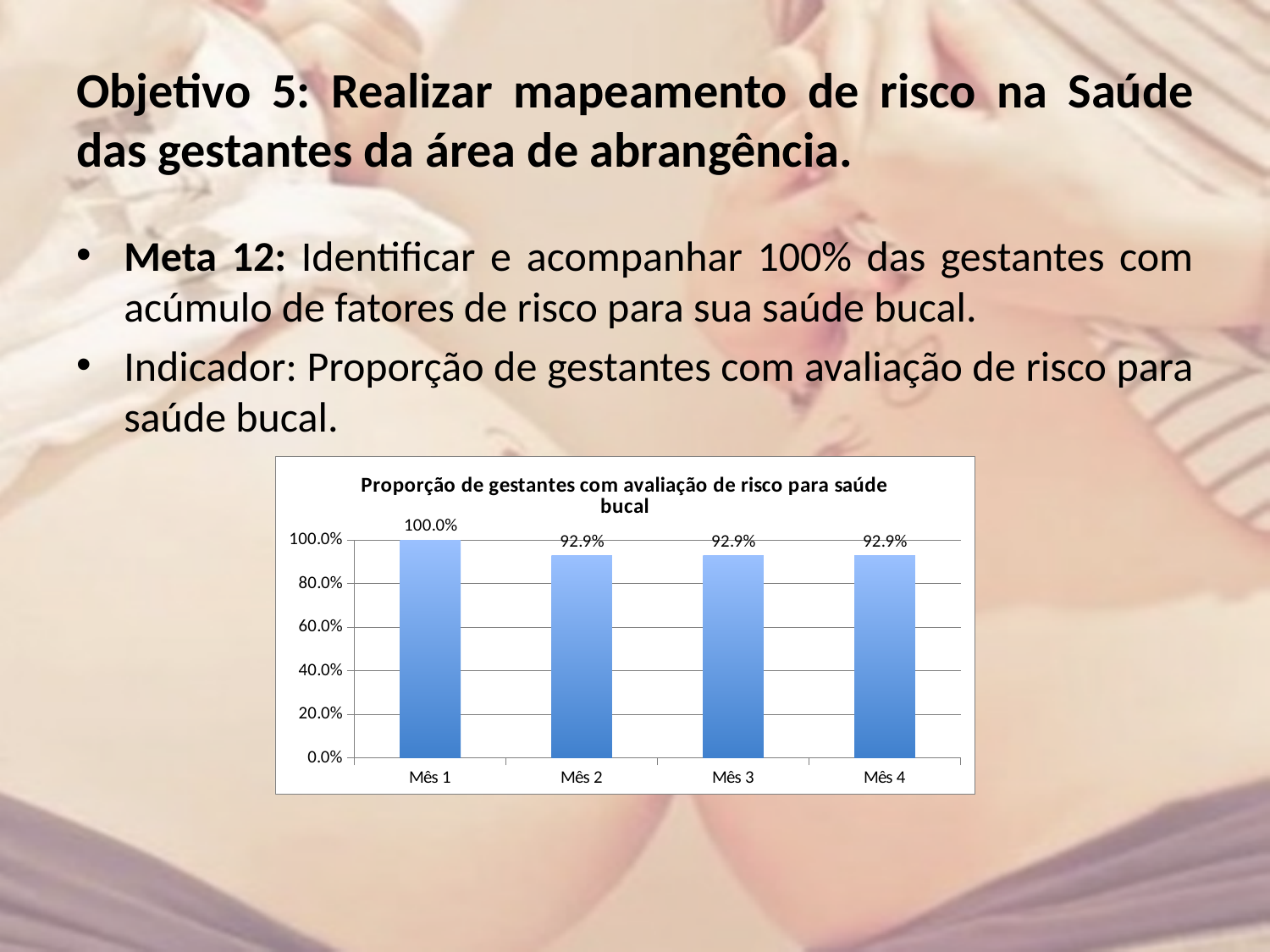
What is the value for Mês 3? 92.9% What is the value for Mês 4? 92.9% Which month has the highest value? Mês 1 What is the value for Mês 1? 100.0% What kind of chart is shown on the slide? bar chart Is the value for Mês 2 greater or less than 80.0%? greater Do the values rise or fall from Mês 1 to Mês 2? fall Which is larger, the value for Mês 1 or the value for Mês 4? Mês 1 What is the difference between the values for Mês 1 and Mês 2? 7.1% What is the title of the chart? Proporção de gestantes com avaliação de risco para saúde bucal What is the highest tick shown on the y axis? 100.0% How many months are shown on the x axis? 4